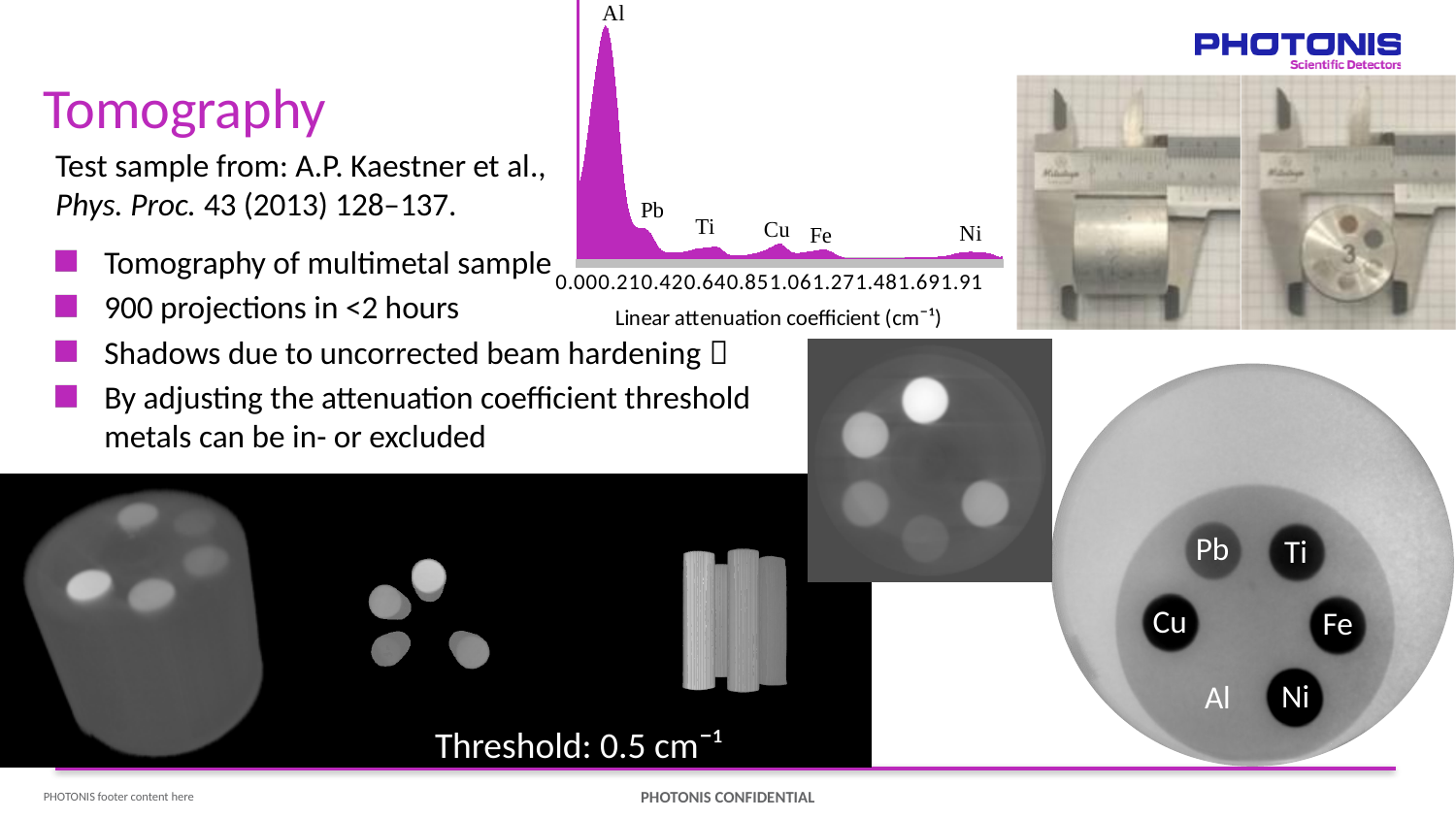
Which peak is taller in the attenuation coefficient chart, Al or Pb? Al What is the highest tick value shown on the x axis of the attenuation coefficient chart? 1.91 Which labelled metal appears at the highest linear attenuation coefficient on the x axis? Ni Is the Ti peak located at a linear attenuation coefficient greater or less than 0.42 cm⁻¹? greater What kind of chart is shown at the top centre of the slide? area chart Which labelled metal has the tallest peak in the attenuation coefficient chart? Al What is the x-axis title of the attenuation coefficient chart? Linear attenuation coefficient (cm⁻¹) How many metals are labelled on the peaks of the attenuation coefficient chart? 6 Does the plotted curve generally rise or fall as the linear attenuation coefficient increases along the x axis? fall Which peak is taller in the attenuation coefficient chart, Pb or Ni? Pb Is the Ni peak located at a linear attenuation coefficient greater or less than 1.69 cm⁻¹? greater Which labelled metal appears at the lowest linear attenuation coefficient on the x axis? Al